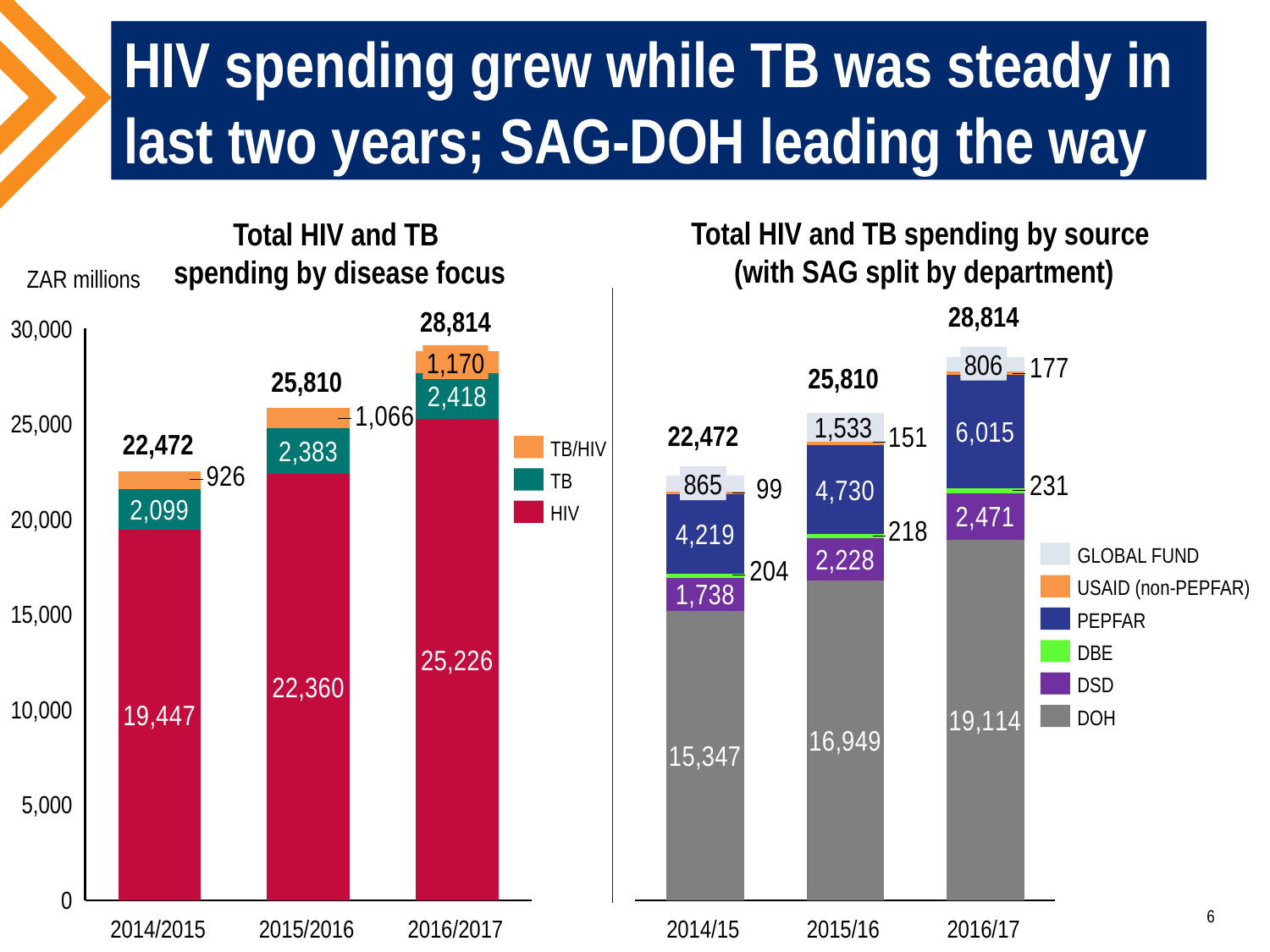
In the 'Total HIV and TB spending by source' chart, what is the DOH value for 2016/17? 19,114 In the 'Total HIV and TB spending by source' chart, how many series does the legend list? 6 In the 'Total HIV and TB spending by source' chart, which year has the lowest DSD value? 2014/15 In the 'Total HIV and TB spending by disease focus' chart, what is the total of the stacked bar for 2015/2016? 25,810 In the 'Total HIV and TB spending by disease focus' chart, which year has the highest HIV value? 2016/2017 In the 'Total HIV and TB spending by disease focus' chart, what is the HIV value for 2016/2017? 25,226 In the 'Total HIV and TB spending by source' chart, what is the PEPFAR value for 2015/16? 4,730 What kind of chart is the 'Total HIV and TB spending by source' chart? Stacked bar chart In the 'Total HIV and TB spending by disease focus' chart, what is the difference between the HIV values for 2015/2016 and 2014/2015? 2,913 In the 'Total HIV and TB spending by disease focus' chart, how many series does the legend list? 3 In the 'Total HIV and TB spending by disease focus' chart, what is the TB/HIV value for 2014/2015? 926 In the 'Total HIV and TB spending by source' chart, is the GLOBAL FUND value larger in 2015/16 or 2016/17? 2015/16